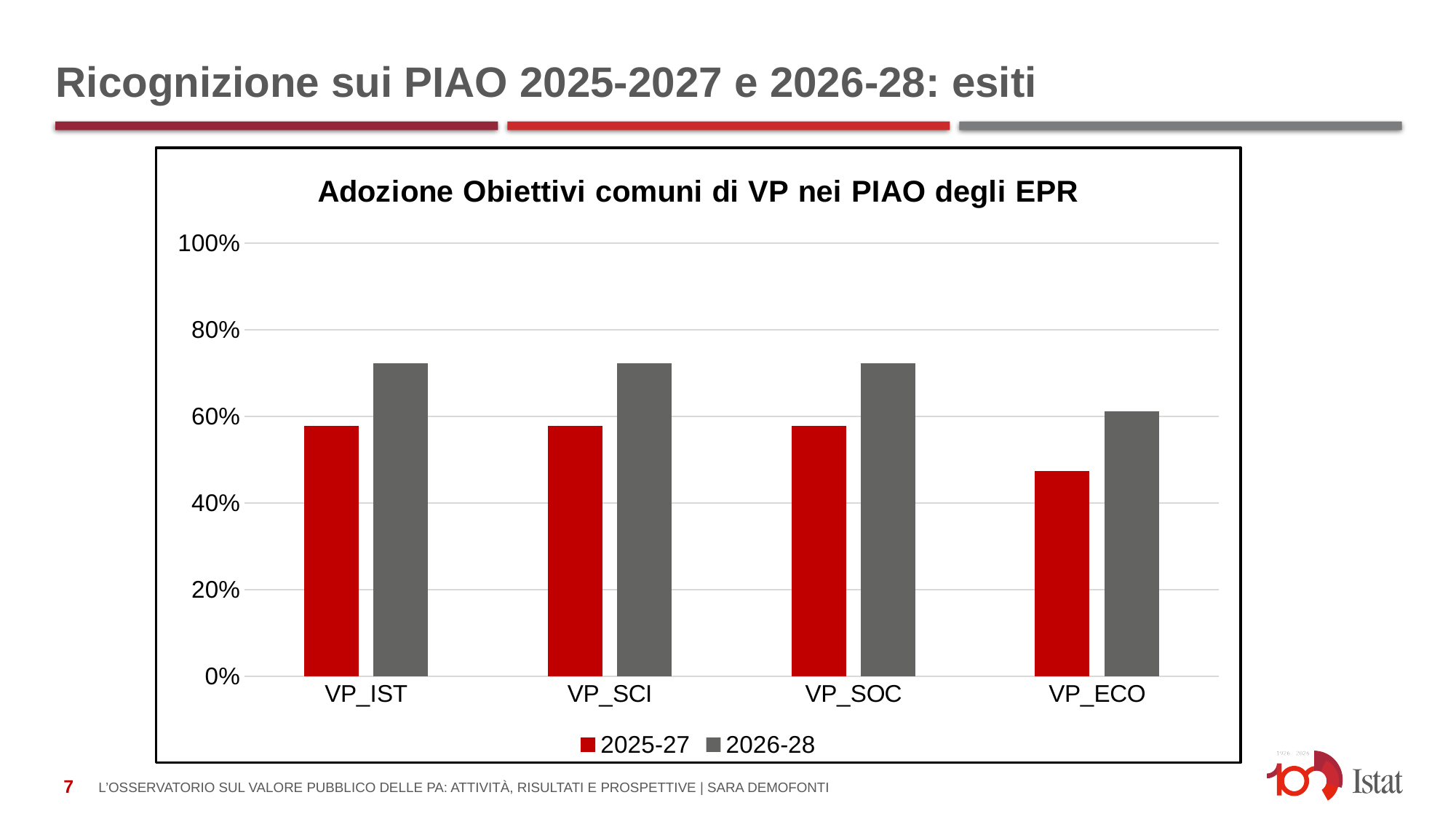
Is the value for VP_SOC in the 2026-28 series greater or less than 80%? less Which category has the lowest value for the 2025-27 series? VP_ECO Which is larger: the 2025-27 value for VP_IST or the 2025-27 value for VP_ECO? VP_IST Which series is shown in red in the chart? 2025-27 What is the title of the chart? Adozione Obiettivi comuni di VP nei PIAO degli EPR For VP_SCI, which series has the larger value, 2025-27 or 2026-28? 2026-28 What kind of chart is shown on the slide? bar chart Is the value for VP_ECO in the 2025-27 series greater or less than 60%? less How many series does the legend list? 2 Is the value for VP_IST in the 2026-28 series greater or less than 60%? greater How many categories are shown on the x axis of the chart? 4 Which category has the lowest value for the 2026-28 series? VP_ECO